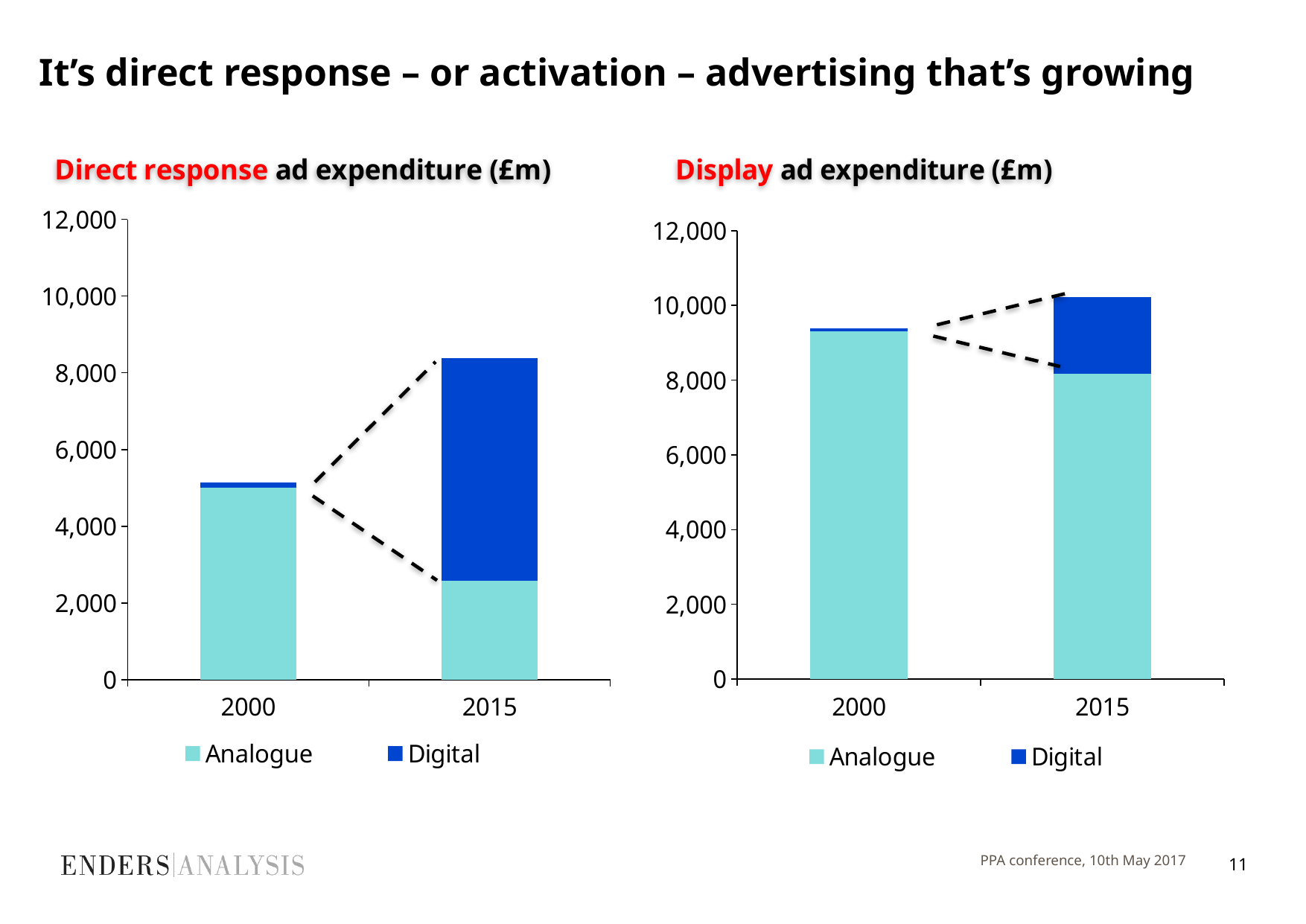
Which series is shown in dark blue in the Display ad expenditure chart? Digital In the Display ad expenditure chart, is the Analogue value for 2015 greater or less than 6,000? greater In the Direct response ad expenditure chart, which year has the higher total expenditure? 2015 What kind of chart is the Direct response ad expenditure chart? Stacked bar chart In the Direct response ad expenditure chart, is the Analogue value for 2015 greater or less than 4,000? less How many series does the legend of the Display ad expenditure chart list? 2 In the Direct response ad expenditure chart, is the total for 2000 greater or less than 6,000? less In the Direct response ad expenditure chart, which year has the larger Analogue value, 2000 or 2015? 2000 How many years are shown on the x axis of the Direct response ad expenditure chart? 2 In the Display ad expenditure chart, does the Digital value rise or fall from 2000 to 2015? rise